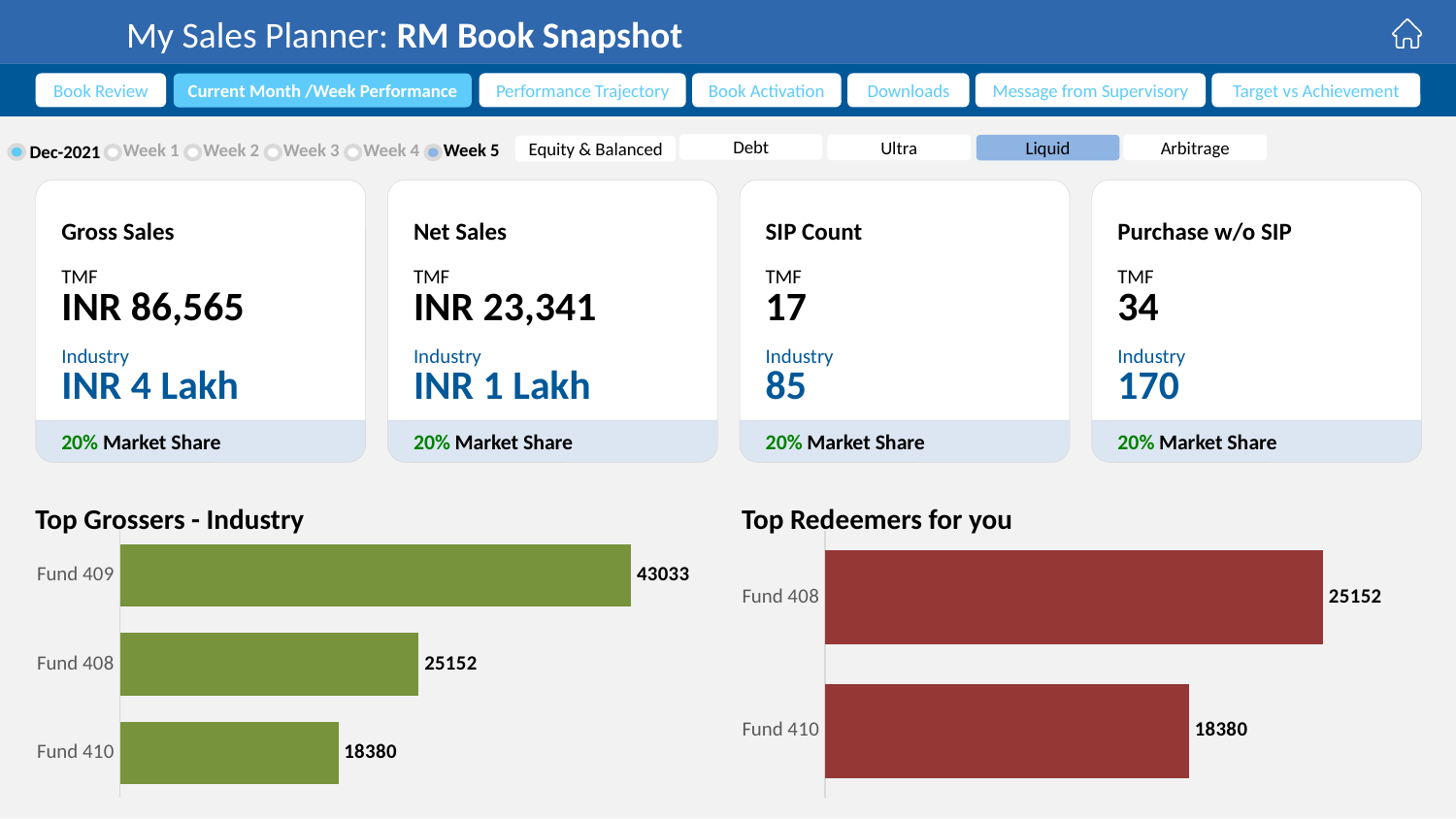
In the 'Top Grossers - Industry' chart, which fund has the highest value? Fund 409 In the 'Top Grossers - Industry' chart, what is the value for Fund 409? 43033 How many funds are shown in the 'Top Redeemers for you' chart? 2 In the 'Top Redeemers for you' chart, which fund has the higher value? Fund 408 In the 'Top Grossers - Industry' chart, what is the difference between the values for Fund 409 and Fund 408? 17881 In the 'Top Grossers - Industry' chart, which fund has the lowest value? Fund 410 In the 'Top Grossers - Industry' chart, what is the value for Fund 410? 18380 How many funds are shown in the 'Top Grossers - Industry' chart? 3 In the 'Top Redeemers for you' chart, what is the value for Fund 408? 25152 In the 'Top Grossers - Industry' chart, which is larger: the value for Fund 408 or Fund 410? Fund 408 What type of chart is the 'Top Redeemers for you' chart? Bar chart In the 'Top Redeemers for you' chart, what is the difference between the values for Fund 408 and Fund 410? 6772